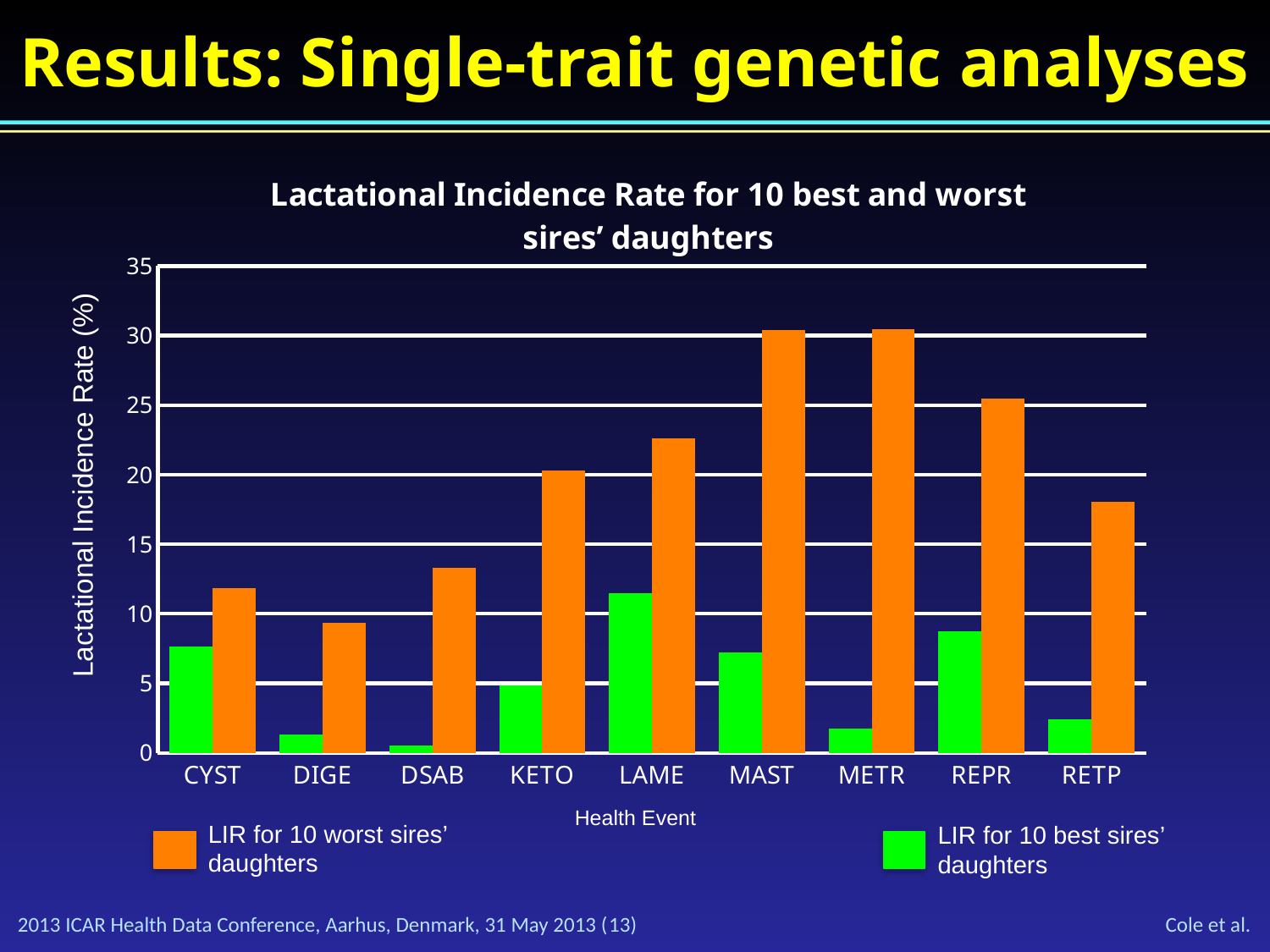
Which health event has the highest LIR for 10 best sires' daughters? LAME Is the LIR for 10 worst sires' daughters for LAME greater or less than 20? greater Which is larger: the LIR for 10 best sires' daughters for REPR or for MAST? REPR What is the label of the y axis of the chart? Lactational Incidence Rate (%) Which health event has the lowest LIR for 10 best sires' daughters? DSAB Is the LIR for 10 worst sires' daughters for RETP greater or less than 20? less How many health events are shown on the x axis of the chart? 9 What kind of chart is shown on the slide? bar chart Is the LIR for 10 worst sires' daughters for DSAB greater or less than 15? less How many series does the chart's legend list? 2 Which health event has the lowest LIR for 10 worst sires' daughters? DIGE